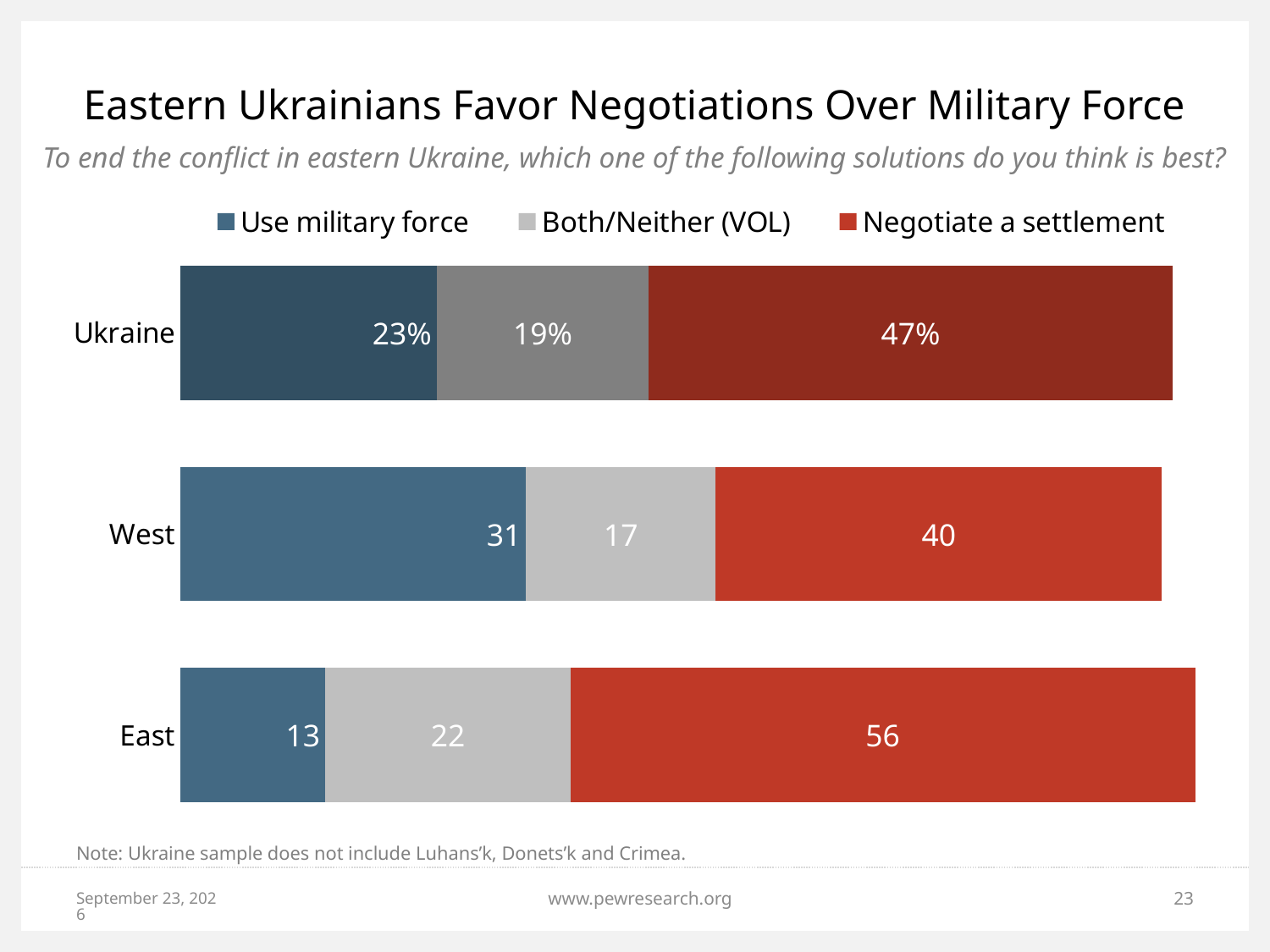
How many regions/categories are shown on the chart? 3 What is the value for "Use military force" in the West? 31 What kind of chart is shown on the slide? Stacked bar chart What percentage of respondents in Ukraine overall chose "Negotiate a settlement"? 47% What is the value for "Both/Neither (VOL)" in the East? 22 Which is larger: "Use military force" in the West or "Use military force" in the East? West What is the difference between the "Negotiate a settlement" values for East and West? 16 Which region has the lowest value for "Use military force"? East How many series does the legend list? 3 Which region has the highest value for "Negotiate a settlement"? East Which legend entry is shown in red? Negotiate a settlement What is the total of the three segments in the East bar? 91